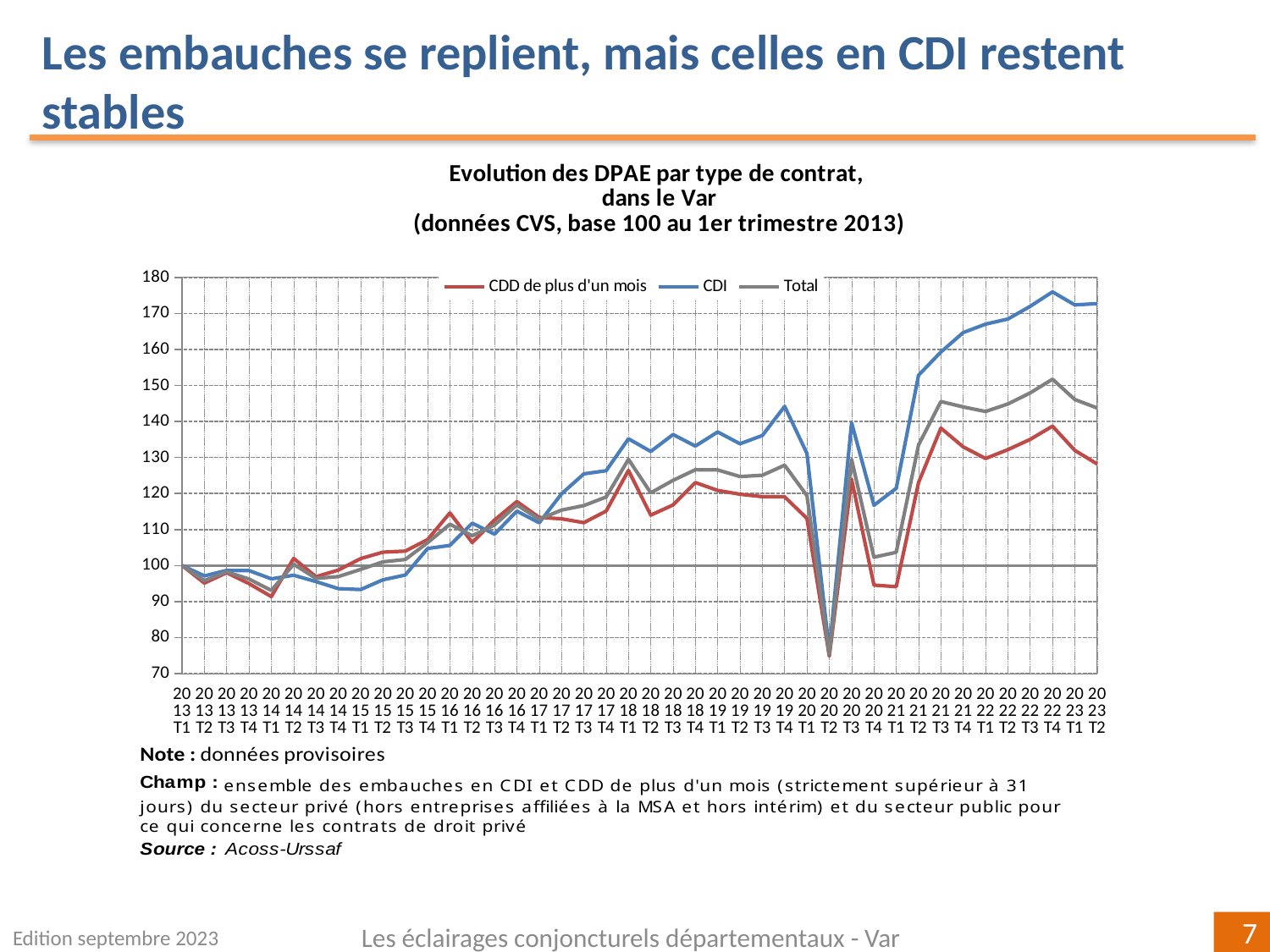
Is the value for CDD de plus d'un mois at 2023 T2 greater or less than 140? less What kind of chart is shown on the slide? line chart Which series has the highest value at 2023 T2? CDI Does the CDI series rise or fall between 2021 T1 and 2022 T4? rise What is the value of all three series at 2013 T1, the base period? 100 Which series has the lowest value at 2023 T2? CDD de plus d'un mois Is the value for CDI at 2023 T2 greater or less than 170? greater What is the source given below the chart? Acoss-Urssaf Is the value for CDI at 2020 T2 greater or less than 80? less How many quarterly points are plotted along the x axis, from 2013 T1 to 2023 T2? 42 How many series does the legend list? 3